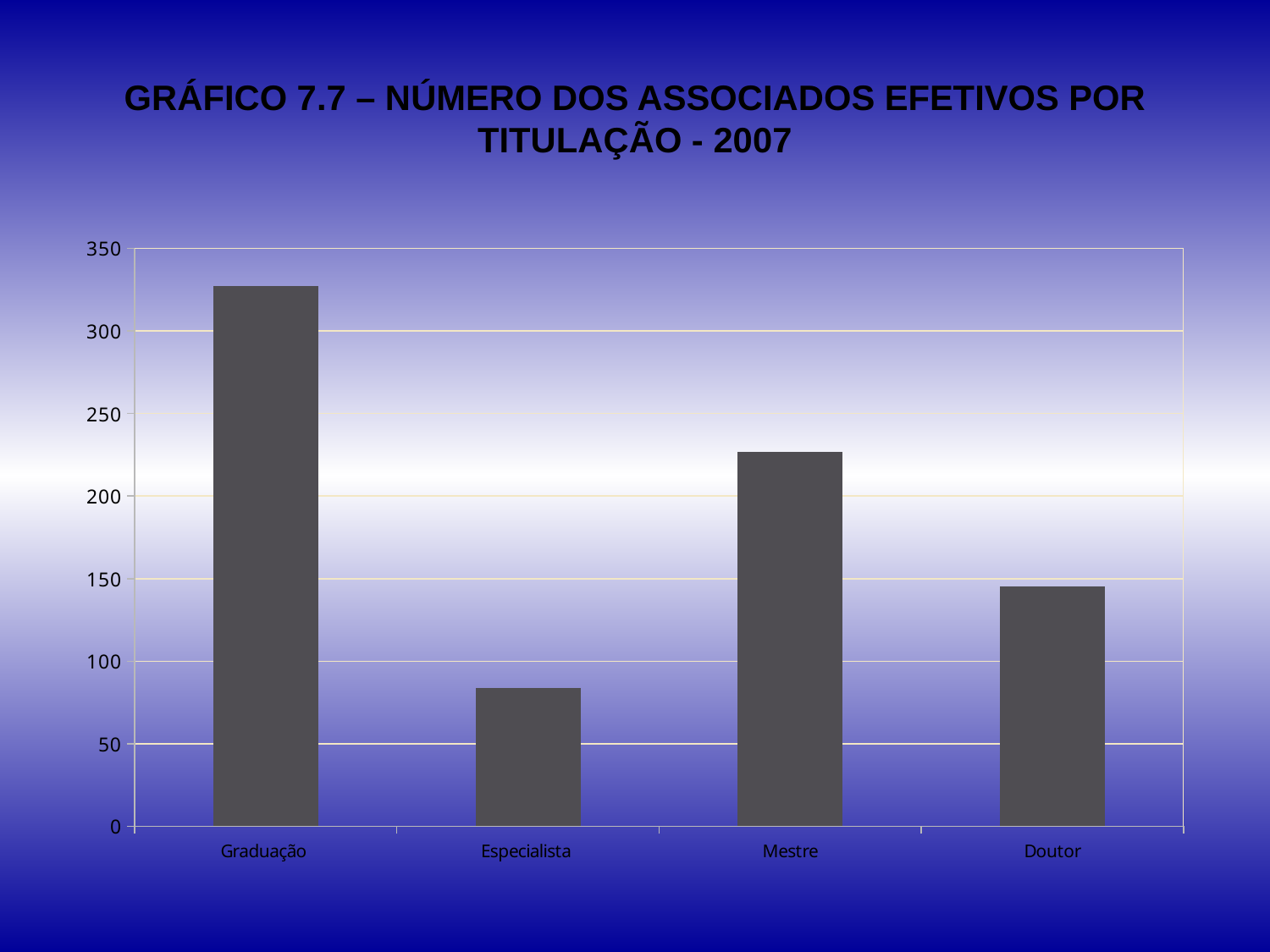
Is the value for Mestre greater or less than 250? less Is the value for Doutor greater or less than 100? greater Which is larger, the value for Mestre or the value for Doutor? Mestre Which category has the highest value in the chart? Graduação Is the value for Mestre greater or less than 200? greater How many categories are shown on the x axis of the chart? 4 What is the title of the chart on the slide? GRÁFICO 7.7 – NÚMERO DOS ASSOCIADOS EFETIVOS POR TITULAÇÃO - 2007 What kind of chart is shown on the slide? Bar chart Which category has the lowest value in the chart? Especialista Which is larger, the value for Especialista or the value for Doutor? Doutor